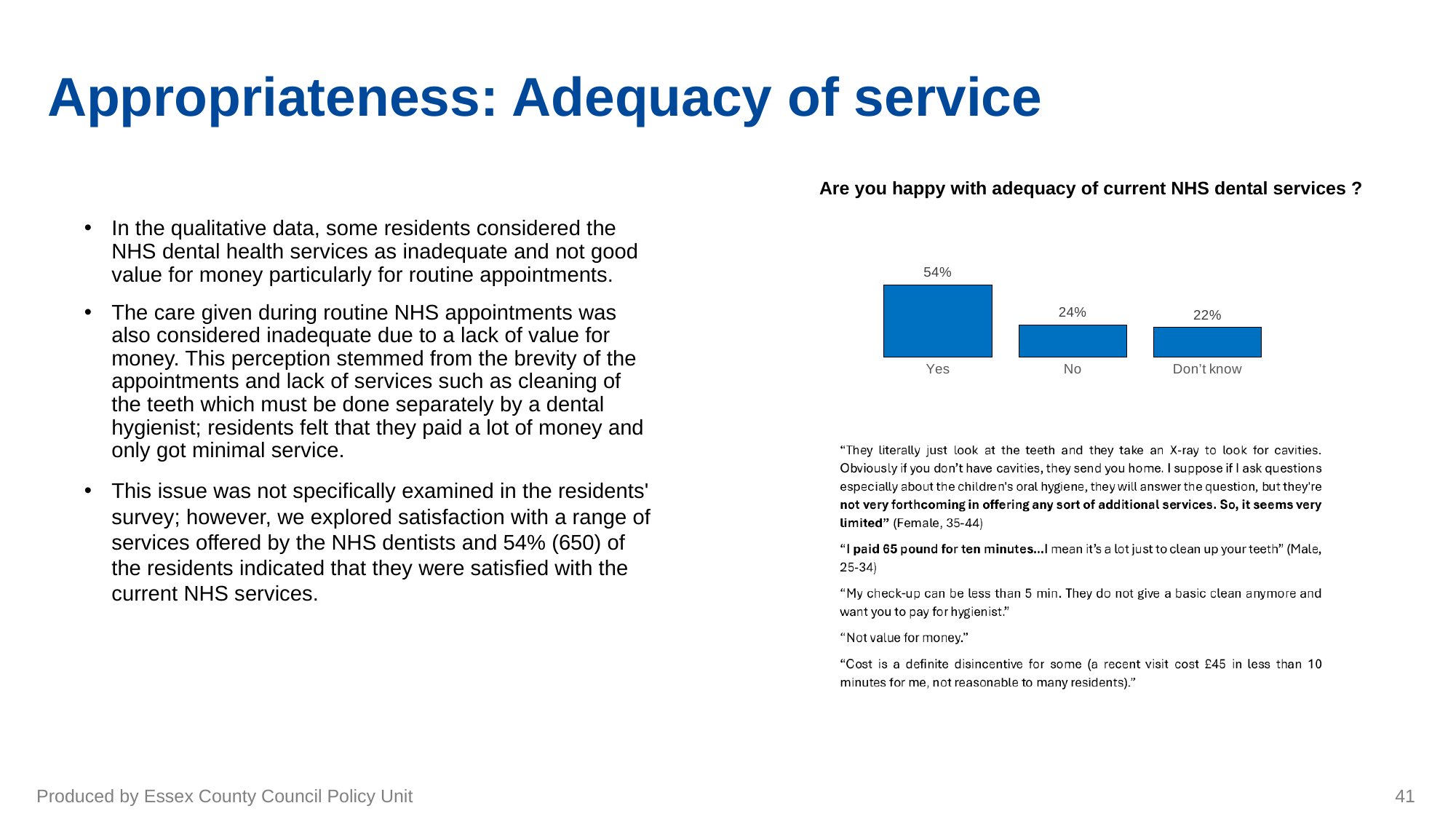
What percentage of respondents answered Don't know? 22% Which response category has the highest value? Yes What percentage of respondents answered No? 24% What is the difference between the No and Don't know percentages? 2% How many response categories are shown in the chart? 3 What is the difference between the Yes and No percentages? 30% Which is larger, the value for Yes or the value for No? Yes What kind of chart is shown on the slide? Bar chart Do the values rise or fall moving from left to right across the categories? Fall What percentage of respondents answered Yes to being happy with the adequacy of current NHS dental services? 54% Which response category has the lowest value? Don't know What is the title of the chart? Are you happy with adequacy of current NHS dental services ?